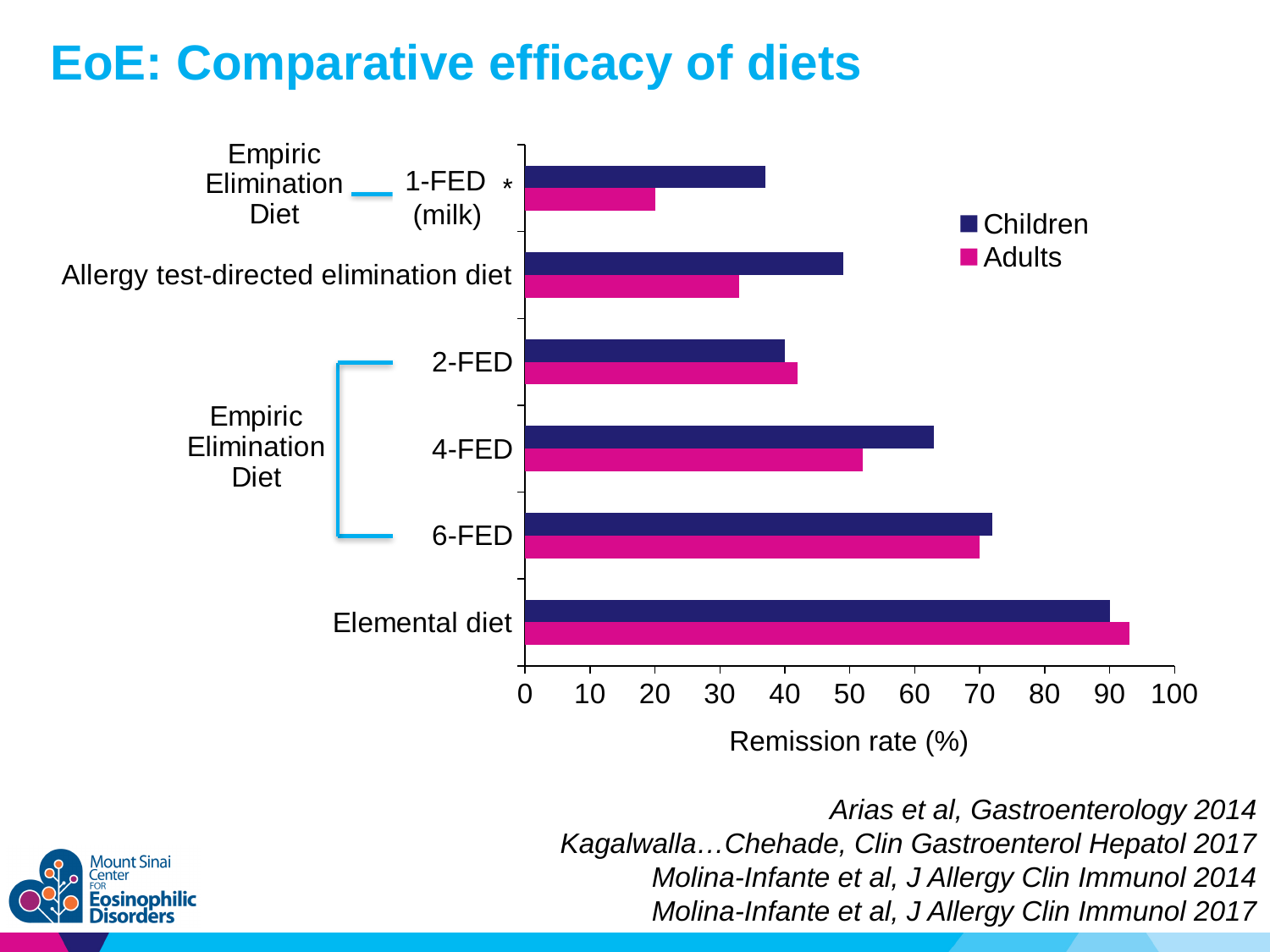
Is the Adults remission rate for 1-FED (milk) greater or less than 30? less For 1-FED (milk), which group has the higher remission rate, Children or Adults? Children Is the Children remission rate for Elemental diet greater or less than 80? greater How many diet categories are plotted on the chart? 6 Which diet has the highest remission rate for Children? Elemental diet Is the Adults remission rate for 6-FED greater or less than 60? greater For 4-FED, which group has the higher remission rate, Children or Adults? Children What is the title of the horizontal axis? Remission rate (%) Which diet has the lowest remission rate for Adults? 1-FED (milk) How many series does the legend list? 2 What kind of chart is shown on the slide? bar chart